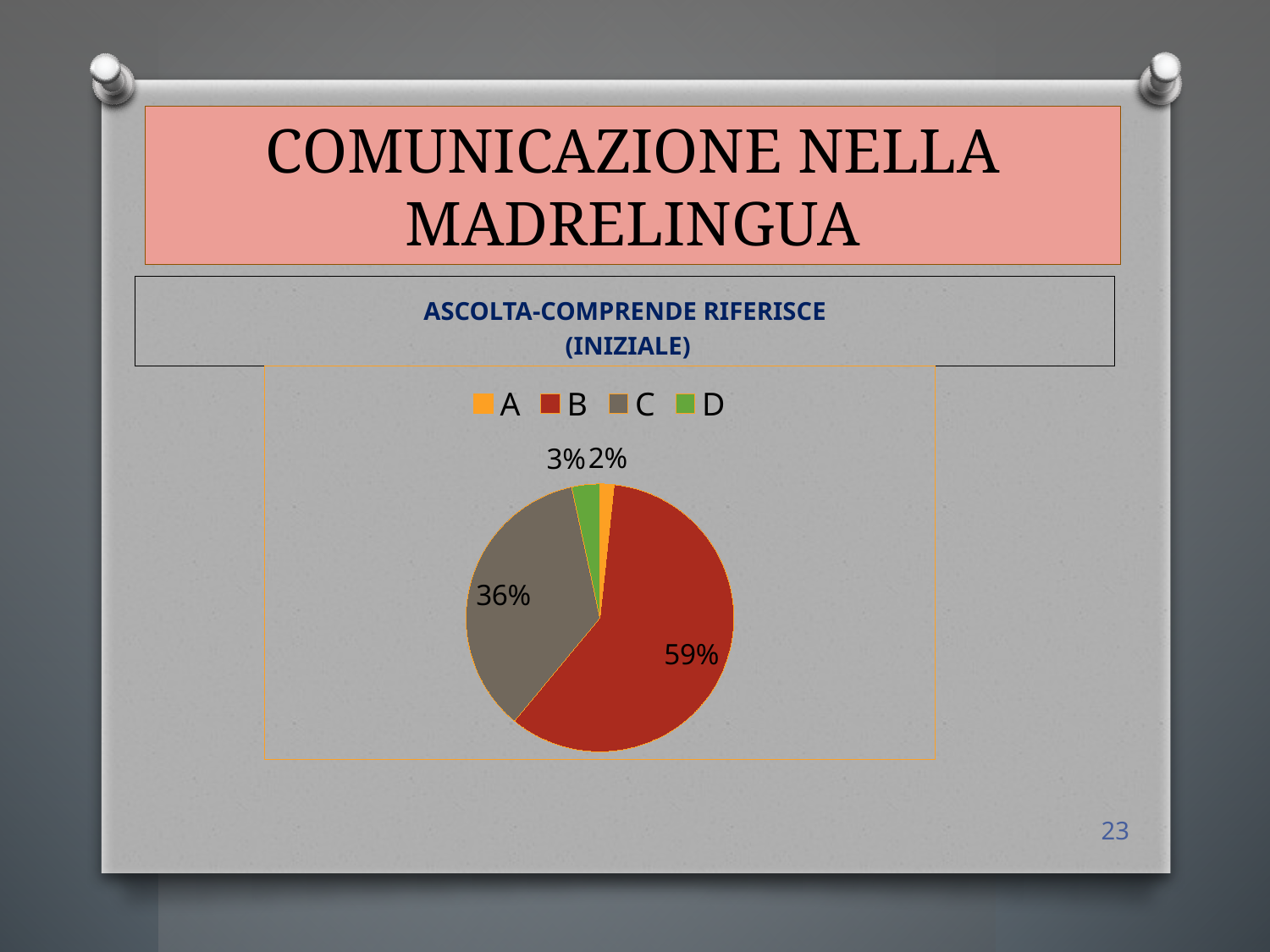
Which is larger, the slice for C or the slice for D? C How many categories does the legend list? 4 Which category has the largest slice of the pie? B What share of the pie does category A have? 2% What share of the pie does category C have? 36% What is the difference in percentage points between category B and category C? 23 What is the title shown above the chart? ASCOLTA-COMPRENDE RIFERISCE (INIZIALE) What share of the pie does category B have? 59% What share of the pie does category D have? 3% What kind of chart is shown on the slide? pie chart Which category has the smallest slice of the pie? A What colour represents category B in the pie chart? red